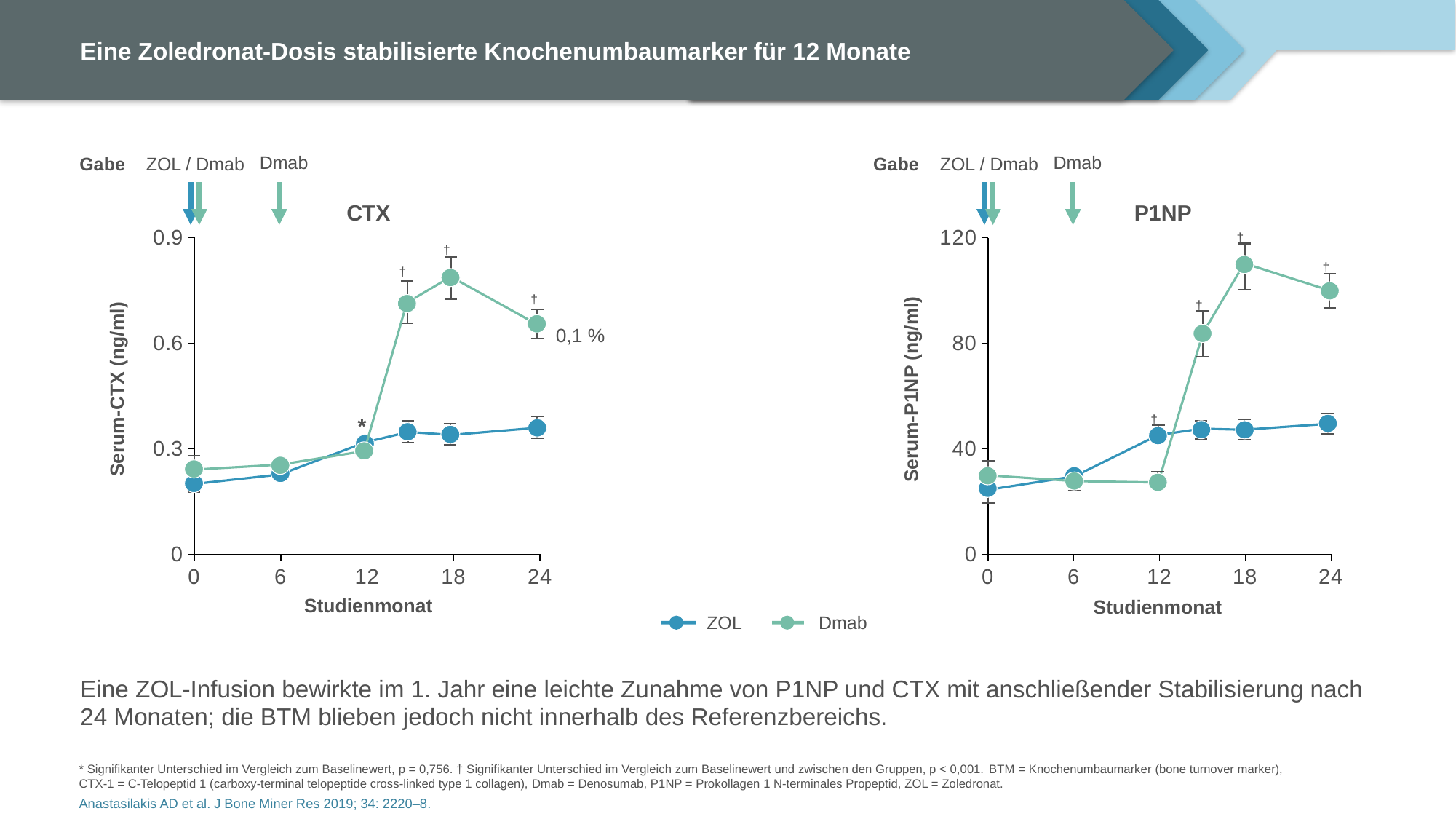
What kind of chart is the CTX chart on the left? line chart In the P1NP chart, at which study month does the Dmab series reach its highest value? 18 In the P1NP chart, is the Dmab value at month 12 greater or less than 40? less In the CTX chart, is the Dmab value at month 18 greater or less than 0.6? greater In the CTX chart, at which study month is the ZOL series at its lowest value? 0 In the CTX chart, at month 24, which series has the higher value, ZOL or Dmab? Dmab In the P1NP chart, how many data points are plotted for the Dmab series? 6 In the CTX chart, is the ZOL value at month 0 greater or less than 0.3? less In the P1NP chart, does the ZOL series rise or fall from month 0 to month 24? rise How many series does the legend list? 2 What is the y-axis label of the P1NP chart? Serum-P1NP (ng/ml)